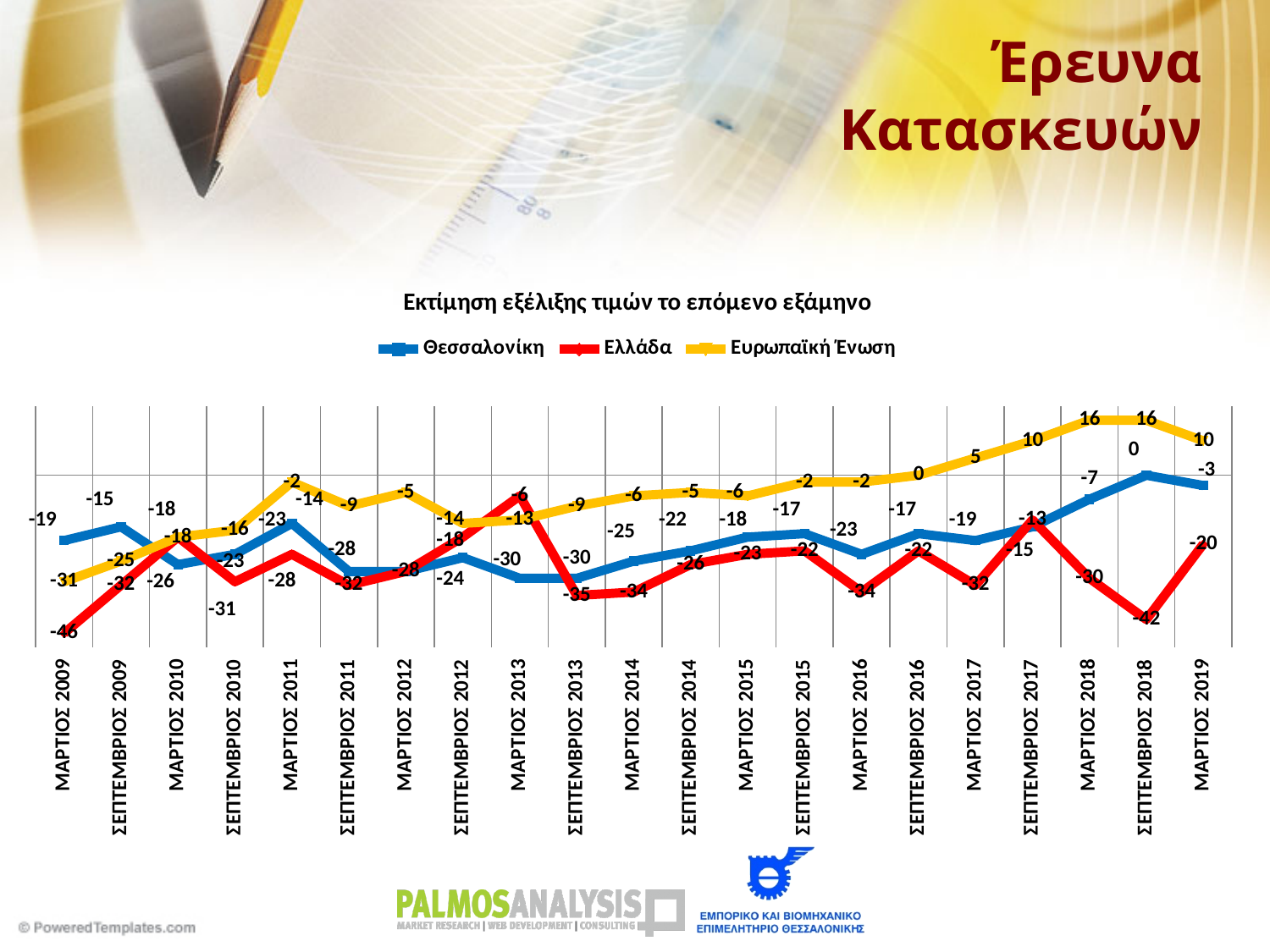
In ΜΑΡΤΙΟΣ 2019, which is higher: Θεσσαλονίκη or Ελλάδα? Θεσσαλονίκη What is the value for Ευρωπαϊκή Ένωση in ΜΑΡΤΙΟΣ 2019? 10 In which period does the Θεσσαλονίκη series reach its highest value? ΣΕΠΤΕΜΒΡΙΟΣ 2018 How many time points are plotted along the x axis? 21 What is the value for Ελλάδα in ΣΕΠΤΕΜΒΡΙΟΣ 2018? -42 What is the difference between the Ευρωπαϊκή Ένωση and Ελλάδα values in ΜΑΡΤΙΟΣ 2019? 30 How many series does the legend list? 3 In which period does the Ελλάδα series reach its lowest value? ΜΑΡΤΙΟΣ 2009 What is the value for Θεσσαλονίκη in ΣΕΠΤΕΜΒΡΙΟΣ 2018? 0 What kind of chart is shown on the slide? Line chart What is the value for Ελλάδα in ΜΑΡΤΙΟΣ 2009? -46 What is the title of the chart? Εκτίμηση εξέλιξης τιμών το επόμενο εξάμηνο